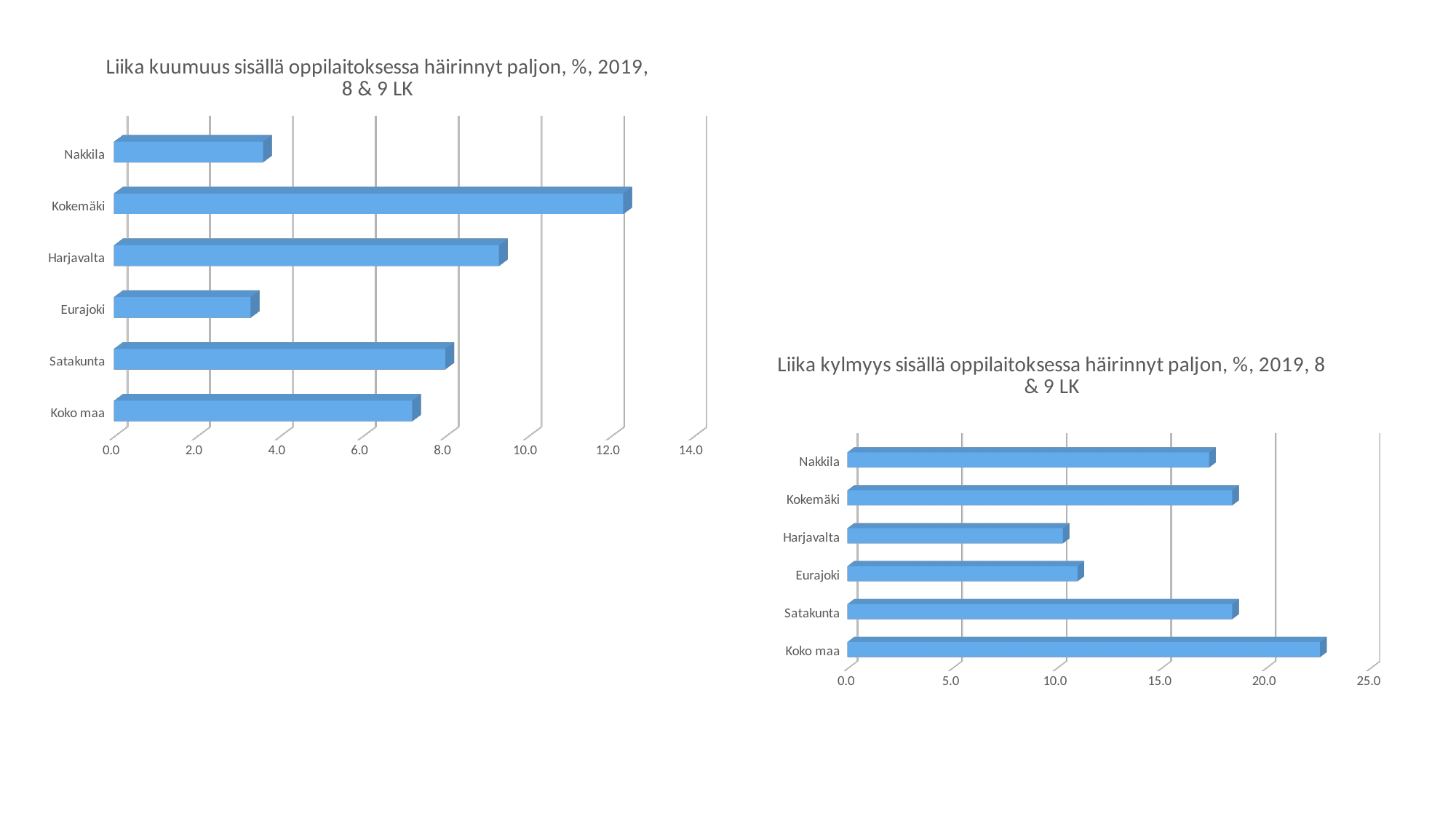
In the left chart (Liika kuumuus), is the value for Nakkila greater or less than 4.0? less In the left chart (Liika kuumuus), which category has the highest value? Kokemäki How many categories are shown in the left chart (Liika kuumuus)? 6 In the right chart (Liika kylmyys), is the value for Koko maa greater or less than 20.0? greater In the right chart (Liika kylmyys), which is larger, the value for Nakkila or the value for Harjavalta? Nakkila In the right chart (Liika kylmyys), which category has the highest value? Koko maa What is the highest value shown on the x axis of the right chart (Liika kylmyys)? 25.0 What type of chart is the left chart titled 'Liika kuumuus sisällä oppilaitoksessa häirinnyt paljon, %, 2019, 8 & 9 LK'? bar chart In the left chart (Liika kuumuus), which is larger, the value for Satakunta or the value for Koko maa? Satakunta In the left chart (Liika kuumuus), is the value for Kokemäki greater or less than 12.0? greater